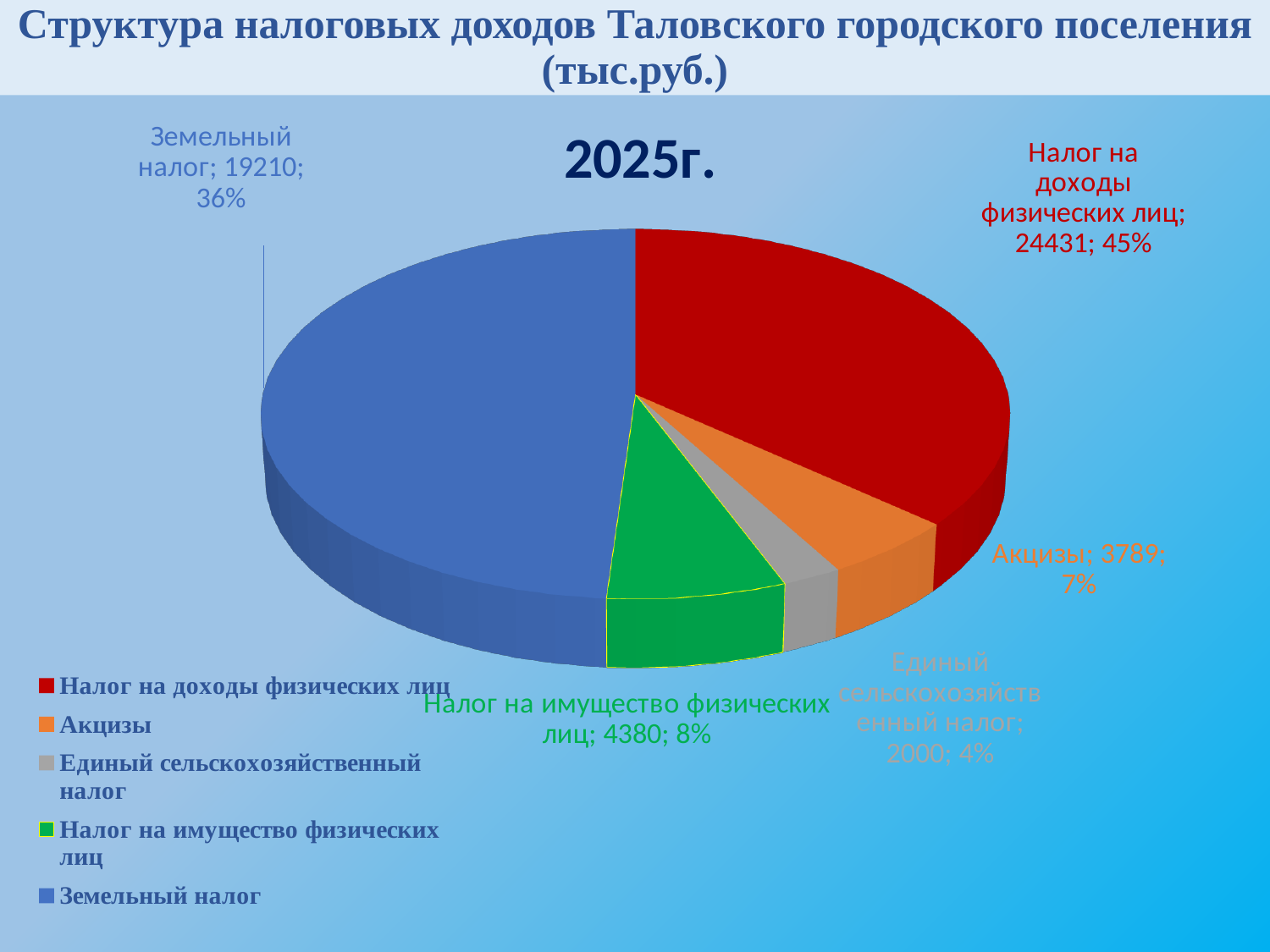
What share of the pie does Единый сельскохозяйственный налог represent? 4% What is the value for Налог на имущество физических лиц in the pie chart? 4380 What is the value for Налог на доходы физических лиц in the pie chart? 24431 Which category has the smallest slice in the pie chart? Единый сельскохозяйственный налог What is the value for Земельный налог in the pie chart? 19210 What is the value for Акцизы in the pie chart? 3789 How many categories does the legend of the pie chart list? 5 What is the difference between the values for Налог на доходы физических лиц and Земельный налог? 5221 What type of chart is shown on the slide? Pie chart What share of the pie does Земельный налог represent? 36% Which is larger, the value for Акцизы or the value for Налог на имущество физических лиц? Налог на имущество физических лиц